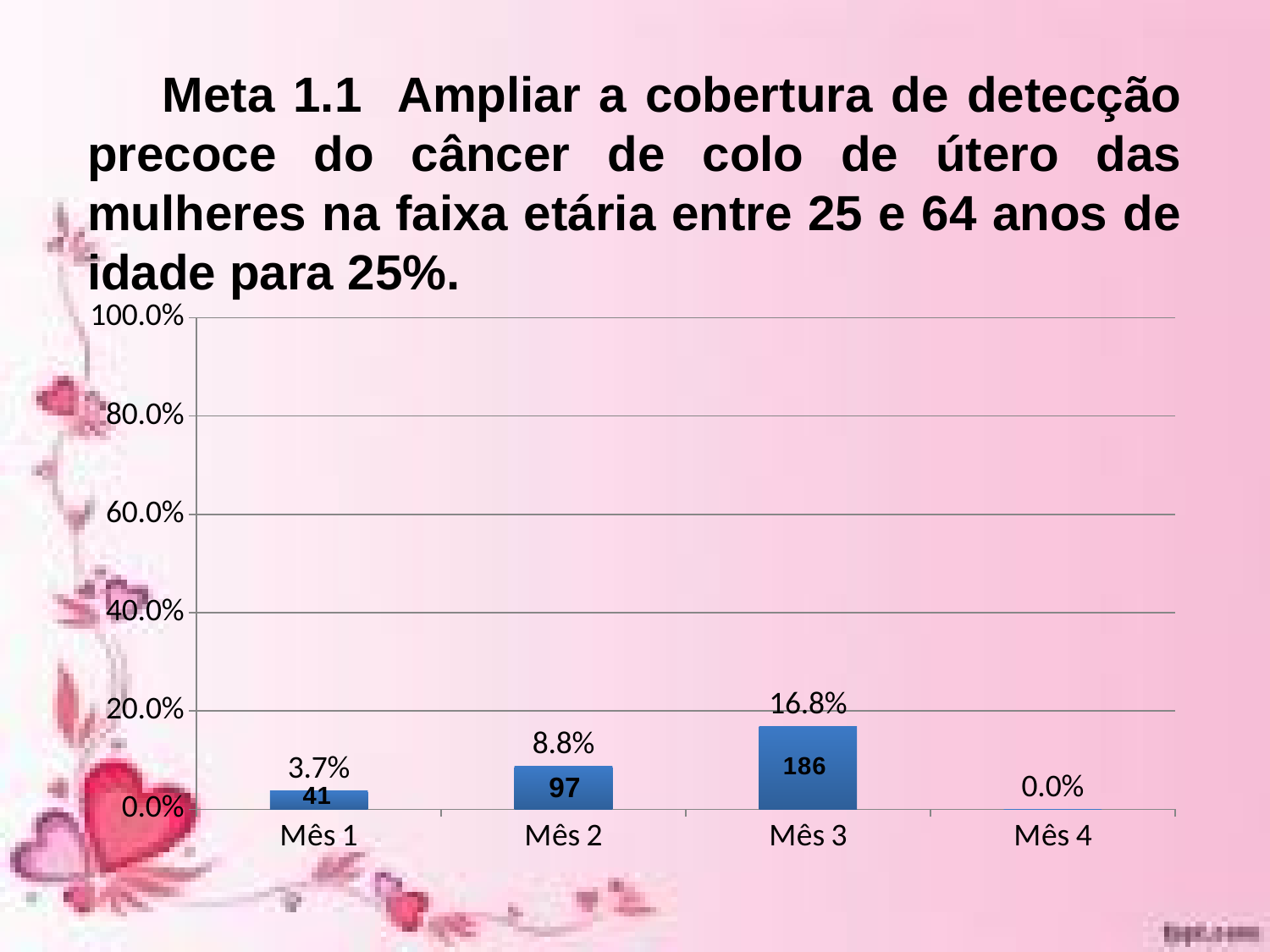
What is the value for Mês 4? 0.0% What kind of chart is shown on the slide? bar chart What is the value for Mês 3? 16.8% Which month has the highest value? Mês 3 What is the value for Mês 1? 3.7% How many months are shown on the x axis? 4 Is the value for Mês 3 greater or less than 20.0%? less What is the difference between the values for Mês 3 and Mês 2? 8.0% Which month has the lowest value? Mês 4 What number is printed inside the bar for Mês 3? 186 What is the value for Mês 2? 8.8% Which is larger, the value for Mês 1 or the value for Mês 2? Mês 2